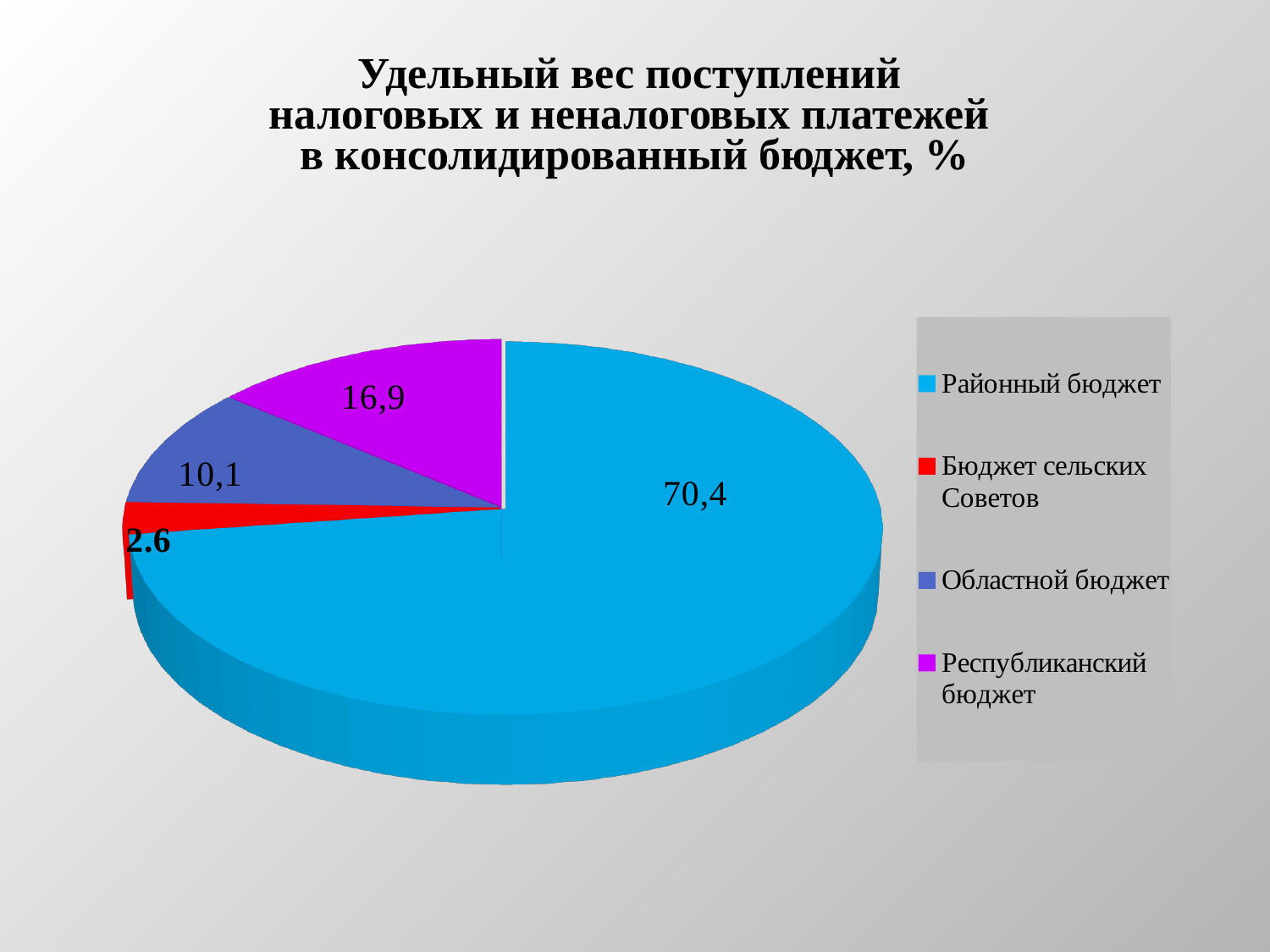
Which category has the smallest slice of the pie? Бюджет сельских Советов What is the value for Бюджет сельских Советов? 2.6 What kind of chart is shown on the slide? pie chart Which is larger, Областной бюджет or Республиканский бюджет? Республиканский бюджет What is the difference between the values for Районный бюджет and Республиканский бюджет? 53,5 What is the value for Областной бюджет? 10,1 What is the value for Республиканский бюджет? 16,9 What colour is the slice for Областной бюджет? blue (dark blue) What is the value for Районный бюджет? 70,4 Which category has the largest slice of the pie? Районный бюджет How many slices does the pie chart have? 4 Which legend entry is shown in red? Бюджет сельских Советов